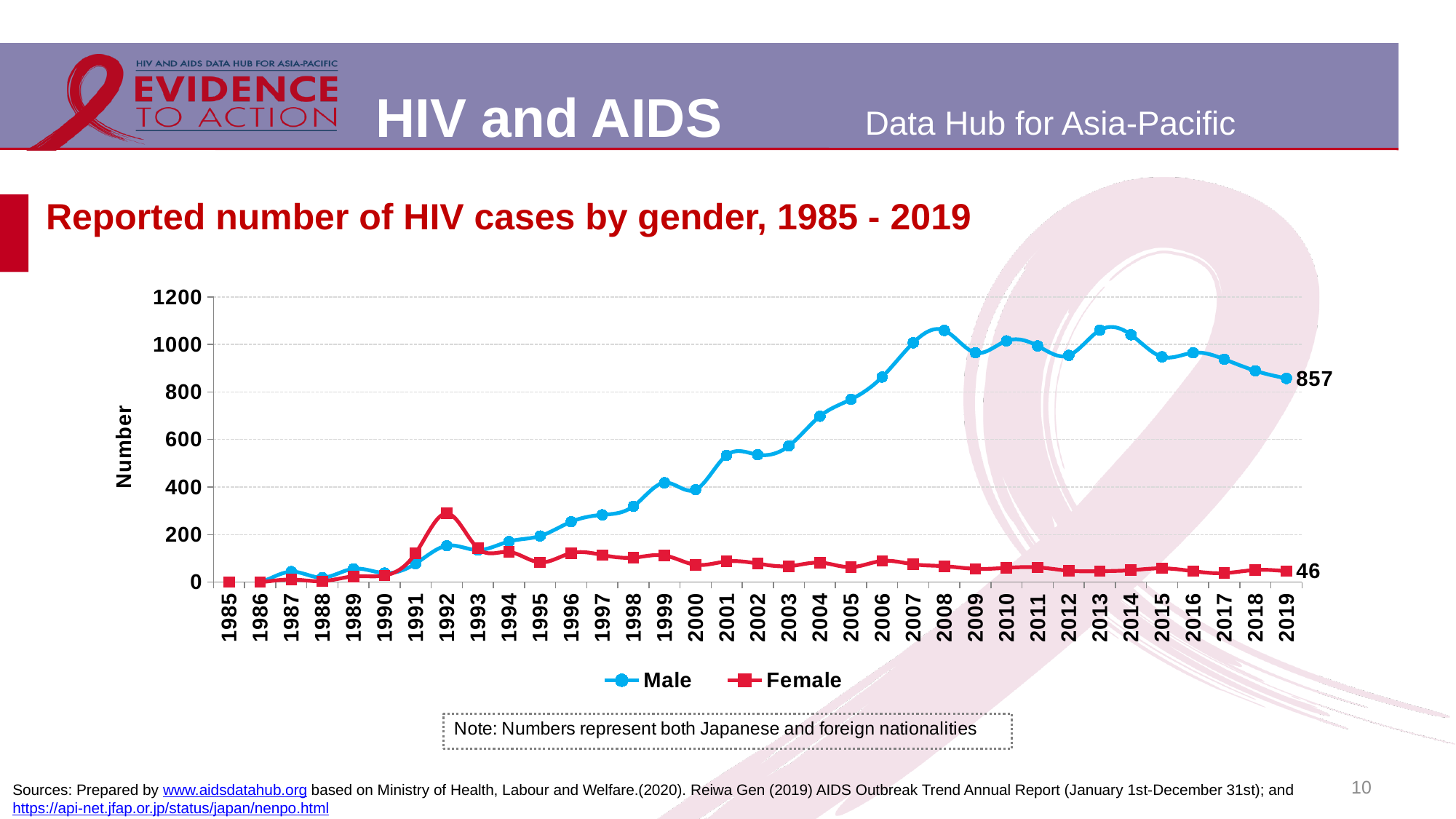
Which series has the larger value in 1992, Male or Female? Female What is the difference between the Male and Female values in 2019? 811 Is the value for Male in 2008 greater or less than 1000? greater Is the value for Female in 1992 greater or less than 200? greater What kind of chart is shown on the slide? Line chart Does the Male series generally rise or fall from 1985 to 2008? rise How many years are shown on the x axis? 35 What is the reported number of HIV cases for Female in 2019? 46 How many series does the legend list? 2 Which series has the larger value in 2019, Male or Female? Male What is the title of the chart? Reported number of HIV cases by gender, 1985 - 2019 What is the reported number of HIV cases for Male in 2019? 857